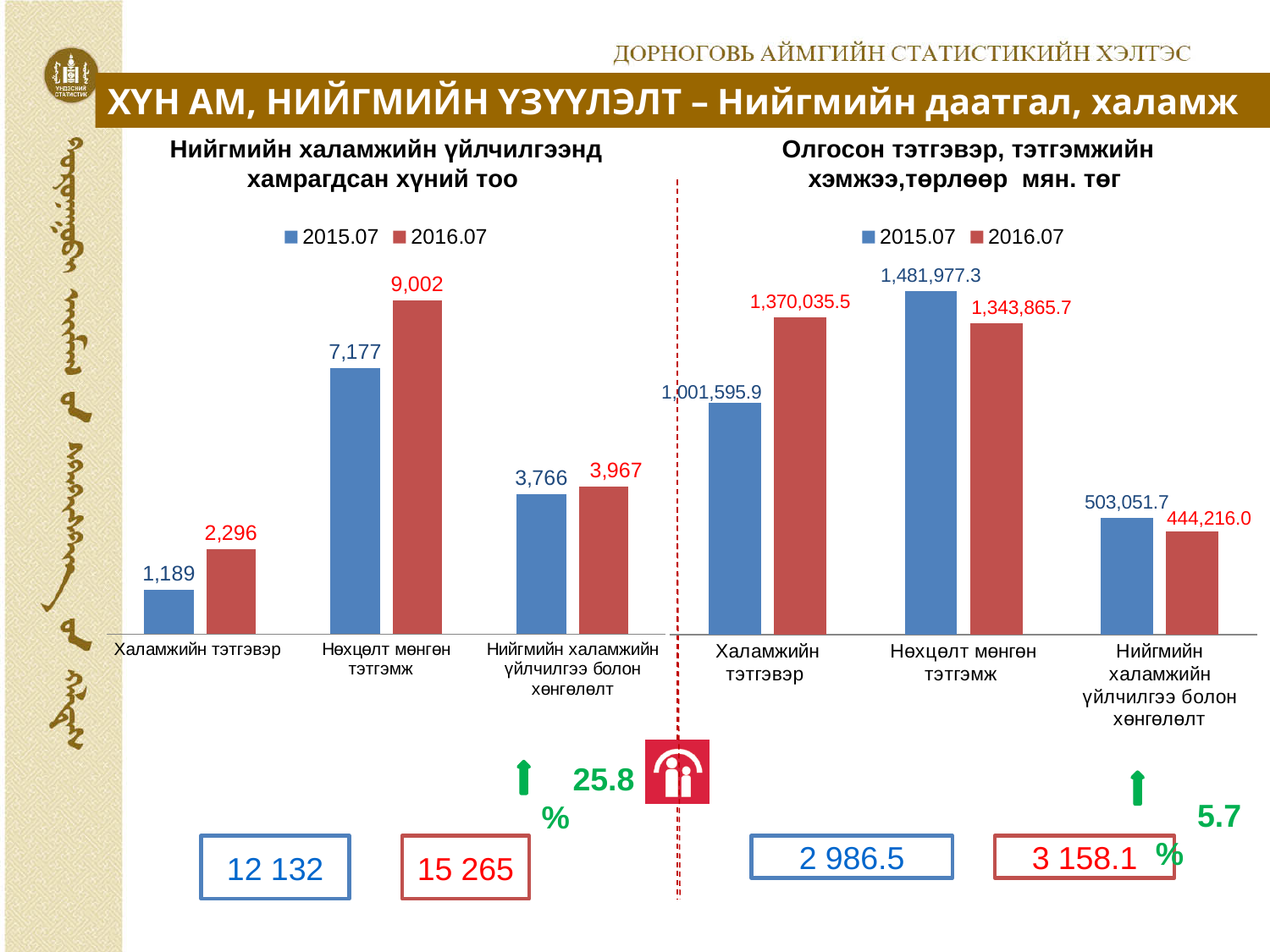
What kind of chart is the left chart (Нийгмийн халамжийн үйлчилгээнд хамрагдсан хүний тоо)? Bar chart In the right chart (Олгосон тэтгэвэр, тэтгэмжийн хэмжээ, төрлөөр мян. төг), what is the value for Нийгмийн халамжийн үйлчилгээ болон хөнгөлөлт in 2016.07? 444,216.0 In the right chart (Олгосон тэтгэвэр, тэтгэмжийн хэмжээ, төрлөөр мян. төг), what is the difference between the 2015.07 and 2016.07 values for Нөхцөлт мөнгөн тэтгэмж? 138,111.6 In the left chart (Нийгмийн халамжийн үйлчилгээнд хамрагдсан хүний тоо), what is the value for Нөхцөлт мөнгөн тэтгэмж in 2016.07? 9,002 In the left chart (Нийгмийн халамжийн үйлчилгээнд хамрагдсан хүний тоо), which category has the lowest value in 2015.07? Халамжийн тэтгэвэр In the right chart (Олгосон тэтгэвэр, тэтгэмжийн хэмжээ, төрлөөр мян. төг), how many categories are shown on the x axis? 3 In the left chart (Нийгмийн халамжийн үйлчилгээнд хамрагдсан хүний тоо), how many series does the legend list? 2 In the right chart (Олгосон тэтгэвэр, тэтгэмжийн хэмжээ, төрлөөр мян. төг), which is larger for Халамжийн тэтгэвэр: the 2015.07 value or the 2016.07 value? 2016.07 In the left chart (Нийгмийн халамжийн үйлчилгээнд хамрагдсан хүний тоо), which category has the highest value in 2016.07? Нөхцөлт мөнгөн тэтгэмж In the right chart (Олгосон тэтгэвэр, тэтгэмжийн хэмжээ, төрлөөр мян. төг), what is the value for Нөхцөлт мөнгөн тэтгэмж in 2015.07? 1,481,977.3 In the left chart (Нийгмийн халамжийн үйлчилгээнд хамрагдсан хүний тоо), what is the difference between the 2016.07 and 2015.07 values for Халамжийн тэтгэвэр? 1,107 In the left chart (Нийгмийн халамжийн үйлчилгээнд хамрагдсан хүний тоо), what is the value for Халамжийн тэтгэвэр in 2015.07? 1,189